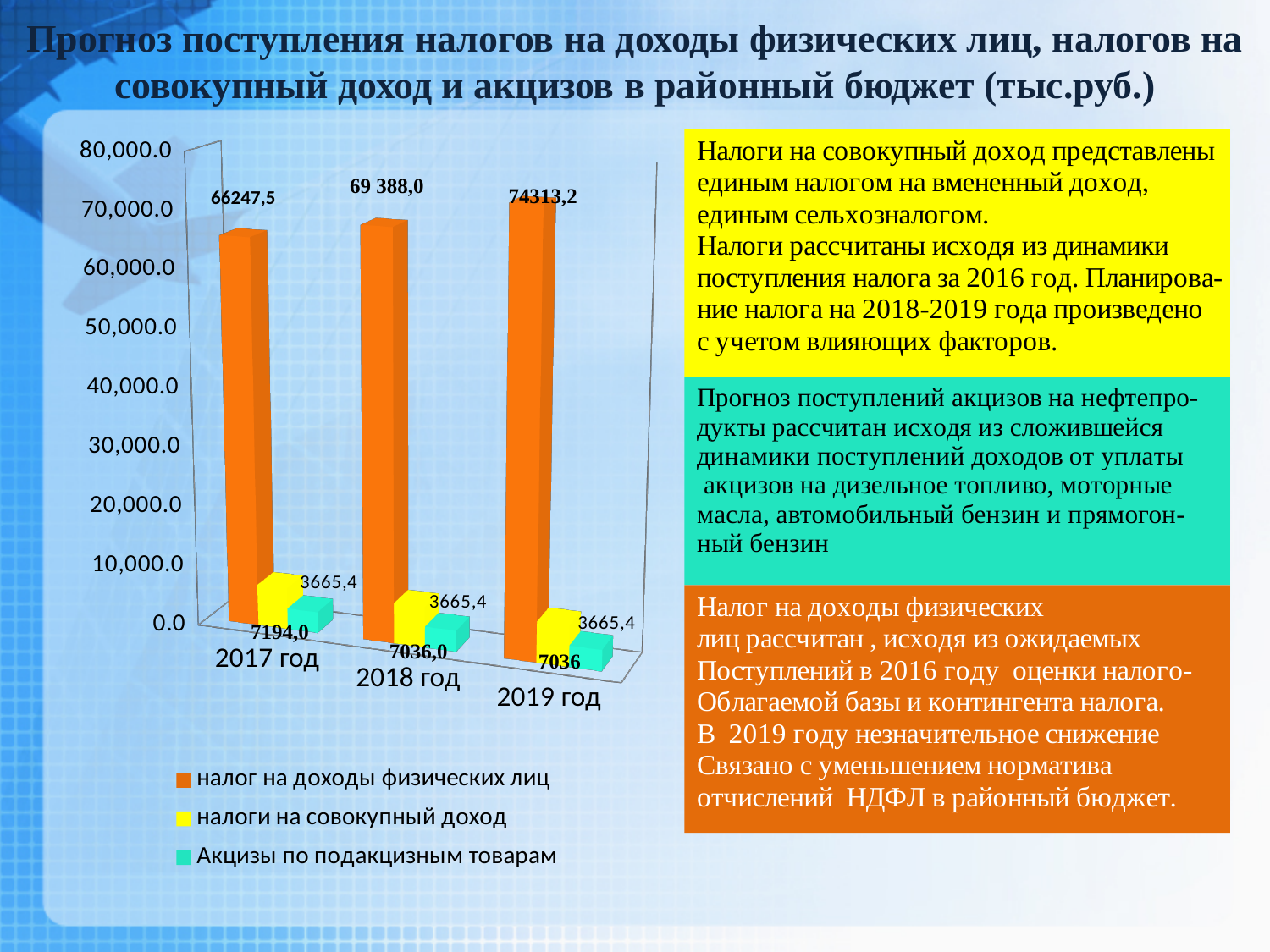
What is the value for налог на доходы физических лиц in 2019 год? 74313,2 How many years are shown on the x axis? 3 What is the value for Акцизы по подакцизным товарам in 2018 год? 3665,4 How many series does the legend list? 3 In which year is налог на доходы физических лиц highest? 2019 год What kind of chart is shown on the slide? bar chart Which is larger: налоги на совокупный доход in 2017 год or in 2018 год? 2017 год What is the value for налог на доходы физических лиц in 2017 год? 66247,5 What is the value for налоги на совокупный доход in 2017 год? 7194,0 Is the value for налог на доходы физических лиц in 2018 год greater or less than 60,000.0? greater In which year is налог на доходы физических лиц lowest? 2017 год Does налог на доходы физических лиц rise or fall from 2017 год to 2019 год? rise